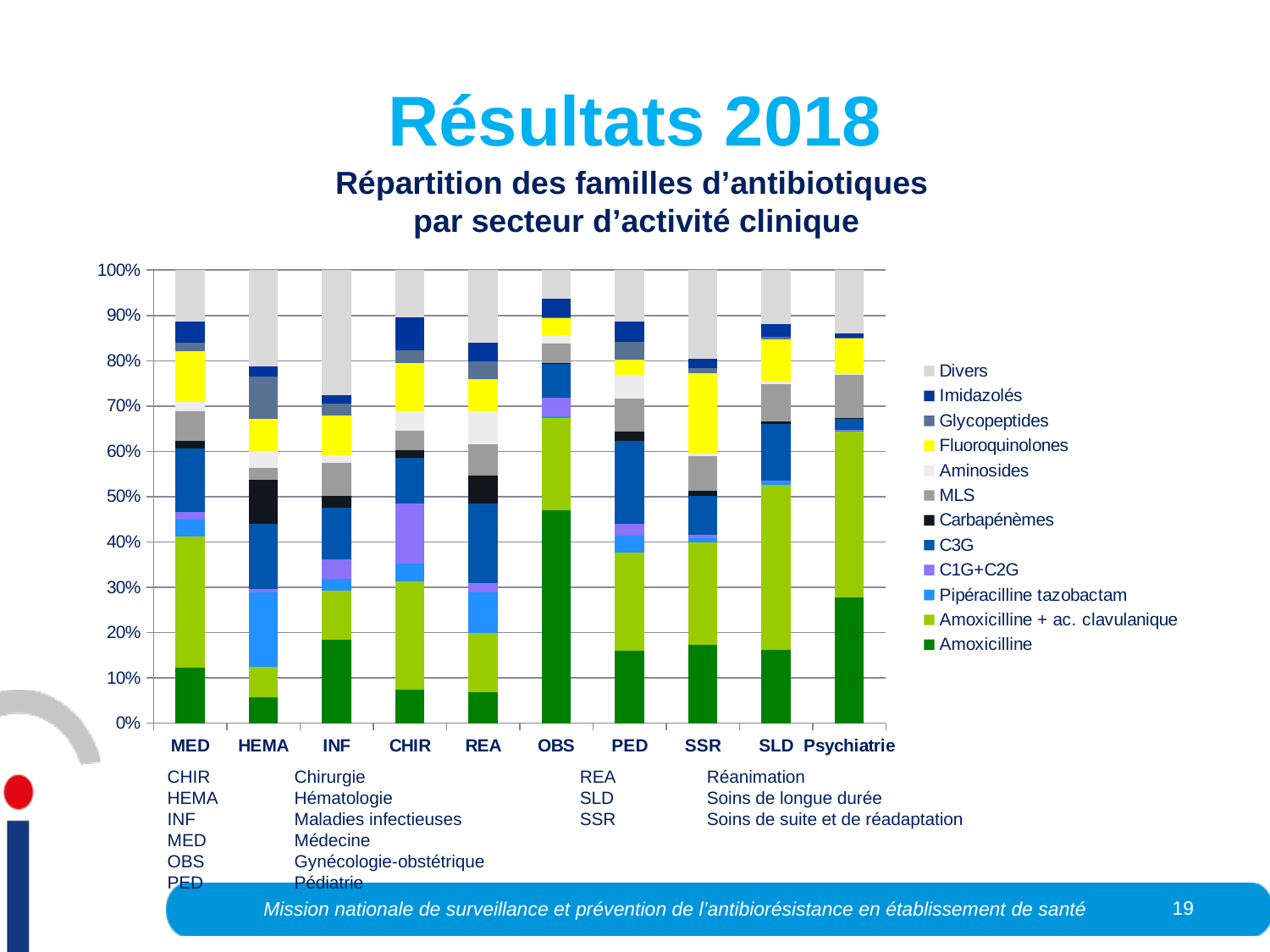
Which sector has the largest Amoxicilline share? OBS What kind of chart is shown on the slide? Stacked bar chart Is the Amoxicilline share for OBS greater or less than 40%? greater Which sector has the largest Pipéracilline tazobactam share? HEMA Is the Amoxicilline share for HEMA greater or less than 10%? less Which sector has the largest Fluoroquinolones share? SSR Which sector has the smallest Divers share? OBS How many clinical sectors (categories) are shown on the x axis of the chart? 10 Which sector has the smallest Amoxicilline + ac. clavulanique share? HEMA How many antibiotic families does the chart legend list? 12 Which is larger, the Amoxicilline share for OBS or for MED? OBS